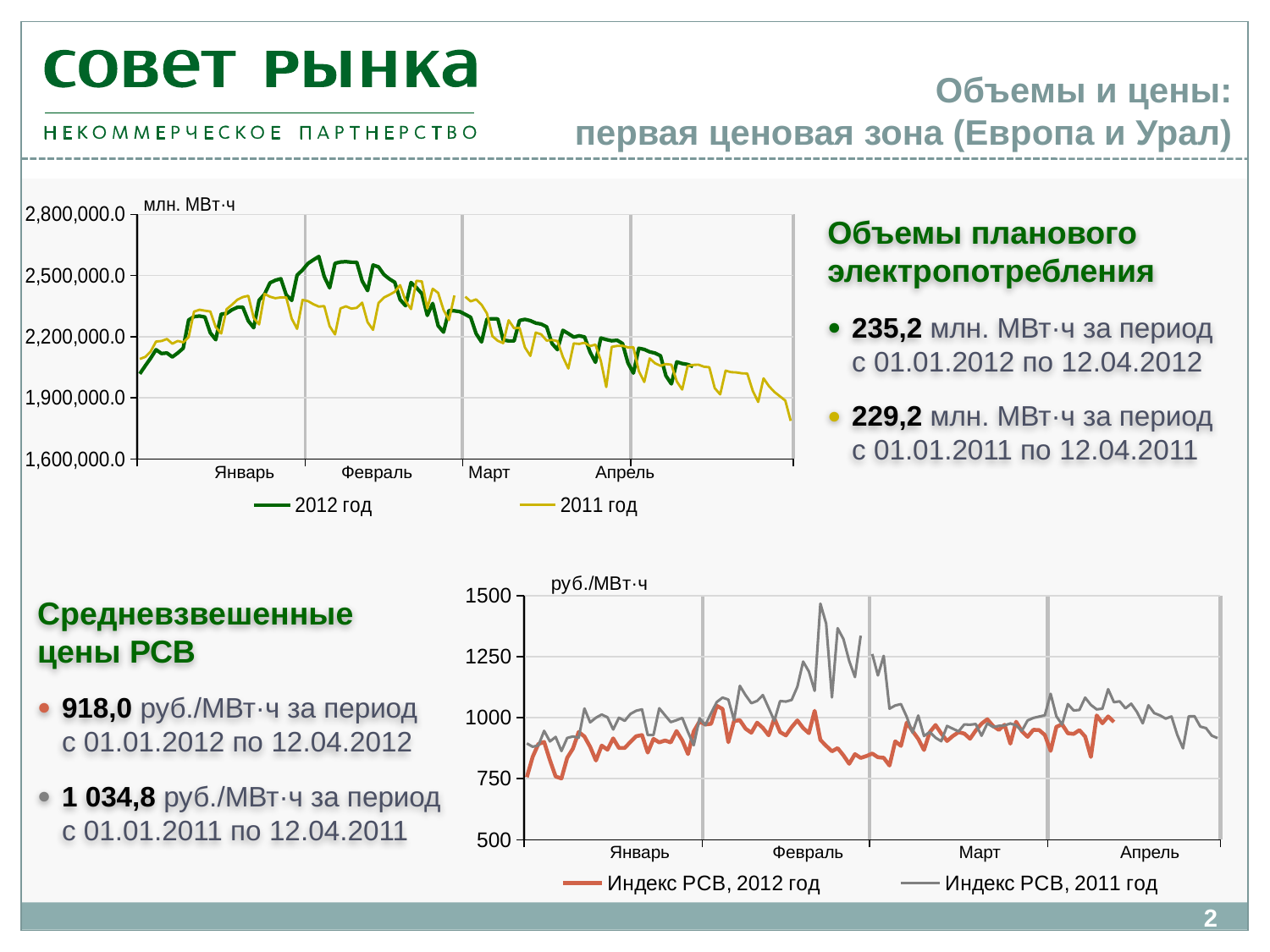
What unit is shown on the y axis of the bottom chart? руб./МВт·ч In the bottom chart, what colour is the Индекс РСВ, 2012 год line? red What kind of chart is the top chart on the slide (planned electricity consumption volumes)? line chart In the bottom chart, during Февраль, which series is higher: Индекс РСВ, 2012 год or Индекс РСВ, 2011 год? Индекс РСВ, 2011 год In the bottom chart, is the peak value of the Индекс РСВ, 2011 год line in Февраль greater or less than 1250? greater How many series does the legend of the bottom chart list? 2 In the top chart, is the peak value of the 2012 год line in Февраль greater or less than 2,500,000.0? greater What kind of chart is the bottom chart on the slide (weighted average РСВ prices)? line chart In the top chart, does the 2012 год line rise or fall from Февраль to Апрель? fall In the top chart, is the value of the 2011 год line at the end of Апрель greater or less than 1,900,000.0? less How many months are labelled on the x axis of the bottom chart? 4 How many series does the legend of the top chart list? 2